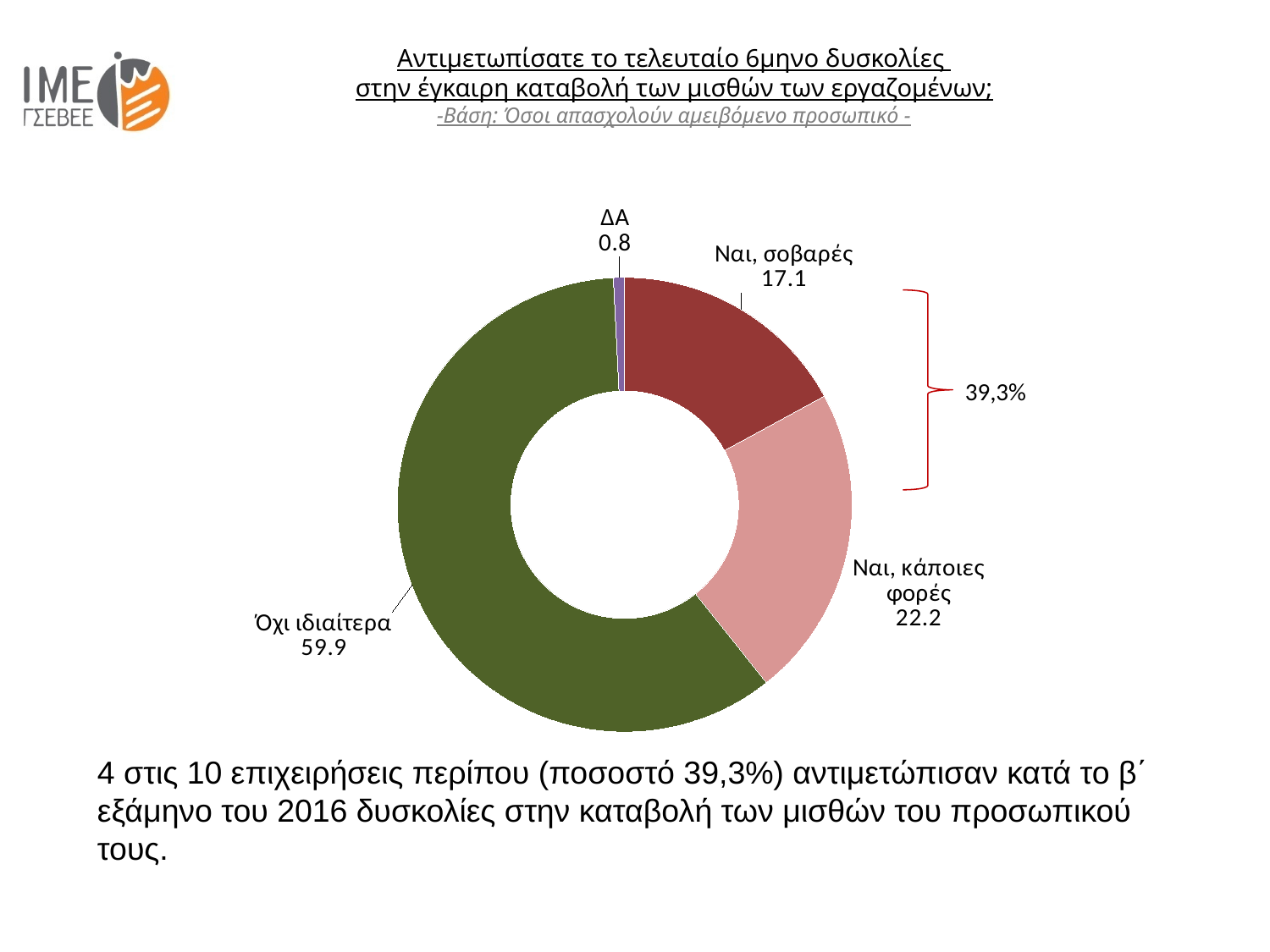
What value is shown for the 'Όχι ιδιαίτερα' slice? 59.9 Which category has the largest slice? Όχι ιδιαίτερα What value is shown for the 'ΔΑ' slice? 0.8 How many slices does the chart have? 4 Which is larger, 'Ναι, σοβαρές' or 'Ναι, κάποιες φορές'? Ναι, κάποιες φορές Which category has the smallest slice? ΔΑ What kind of chart is shown on the slide? Doughnut (pie) chart What combined percentage is indicated by the red bracket next to the two 'Ναι' slices? 39,3% What colour is the 'Όχι ιδιαίτερα' slice? Green What is the difference between the 'Ναι, κάποιες φορές' and 'Ναι, σοβαρές' values? 5.1 What value is shown for the 'Ναι, κάποιες φορές' slice? 22.2 What value is shown for the 'Ναι, σοβαρές' slice? 17.1